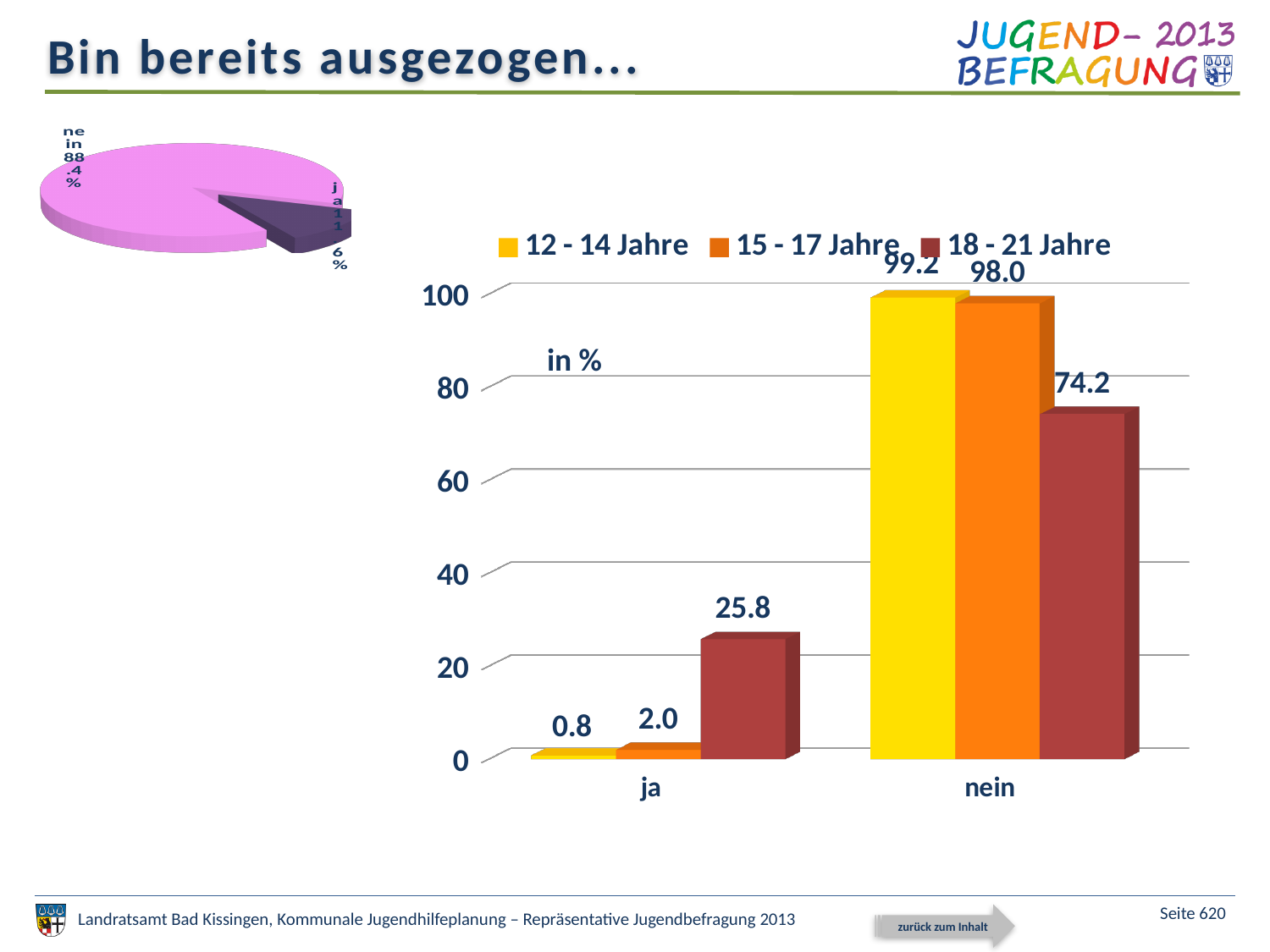
In the bar chart, which is larger for 15 - 17 Jahre: the 'ja' value or the 'nein' value? nein In the bar chart, which age group has the highest value in the 'ja' category? 18 - 21 Jahre In the pie chart on the left, what share does the 'nein' slice have? 88.4% In the bar chart, what is the difference between the 12 - 14 Jahre and 18 - 21 Jahre values in the 'nein' category? 25.0 In the bar chart, what is the value for 18 - 21 Jahre in the 'ja' category? 25.8 What kind of chart is the chart on the right side of the slide? bar chart How many categories are shown on the x axis of the bar chart? 2 In the bar chart, is the value for 18 - 21 Jahre in the 'nein' category greater or less than 80? less In the bar chart, what is the value for 12 - 14 Jahre in the 'nein' category? 99.2 In the bar chart, what is the value for 15 - 17 Jahre in the 'ja' category? 2.0 In the bar chart, which age group has the lowest value in the 'nein' category? 18 - 21 Jahre How many series does the legend of the bar chart list? 3